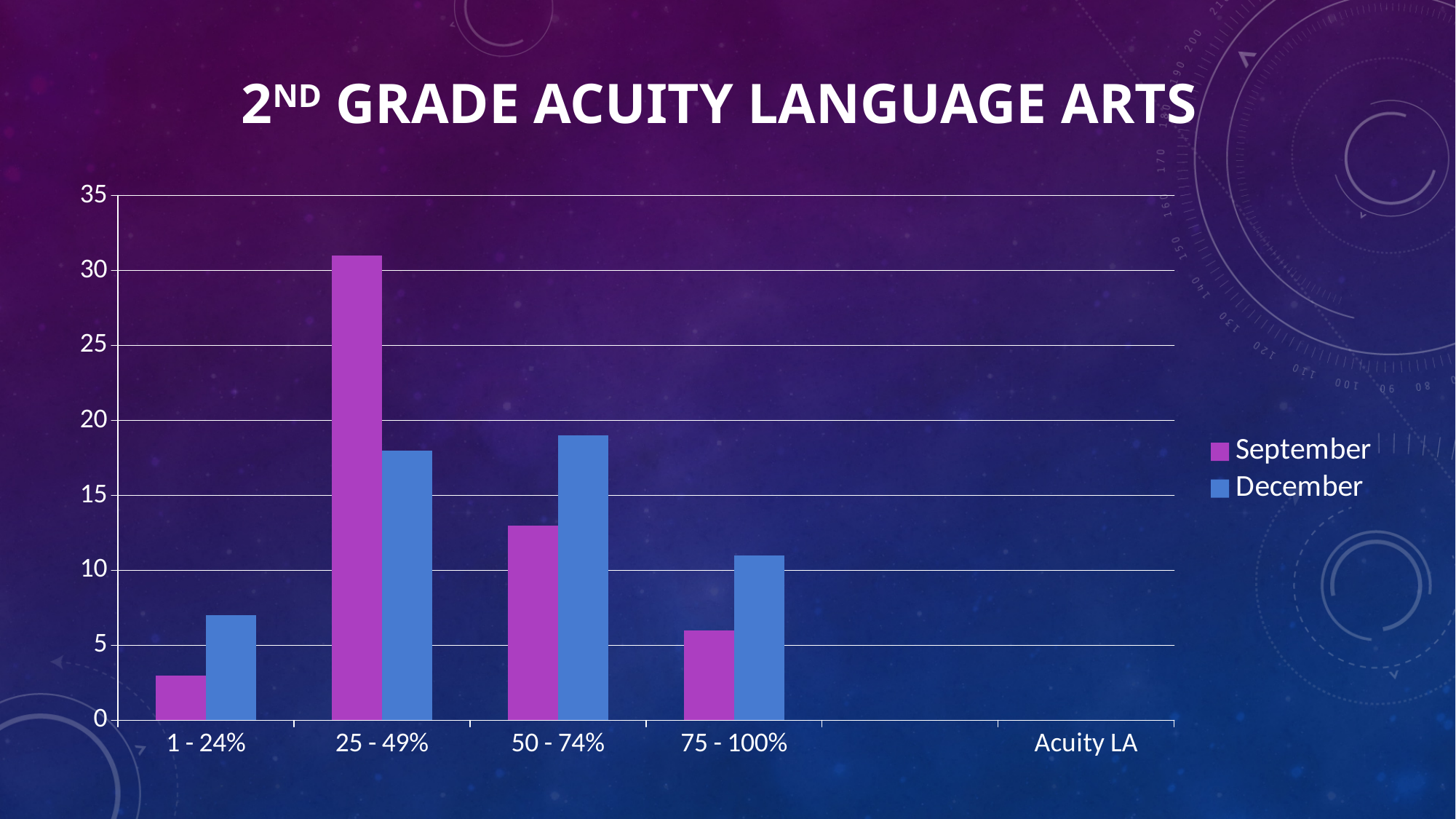
Which category has the lowest September value? 1 - 24% Which category has the highest September value? 25 - 49% What type of chart is shown on the slide? bar chart Which series is shown in purple? September For the 25 - 49% category, which is larger, September or December? September Is the September value for 25 - 49% greater or less than 25? greater How many series does the legend list? 2 Which category has the lowest December value? 1 - 24% What is the title of the chart? 2nd Grade Acuity Language Arts For the 50 - 74% category, which is larger, September or December? December Is the December value for 75 - 100% greater or less than 15? less Is the September value for 1 - 24% greater or less than 5? less